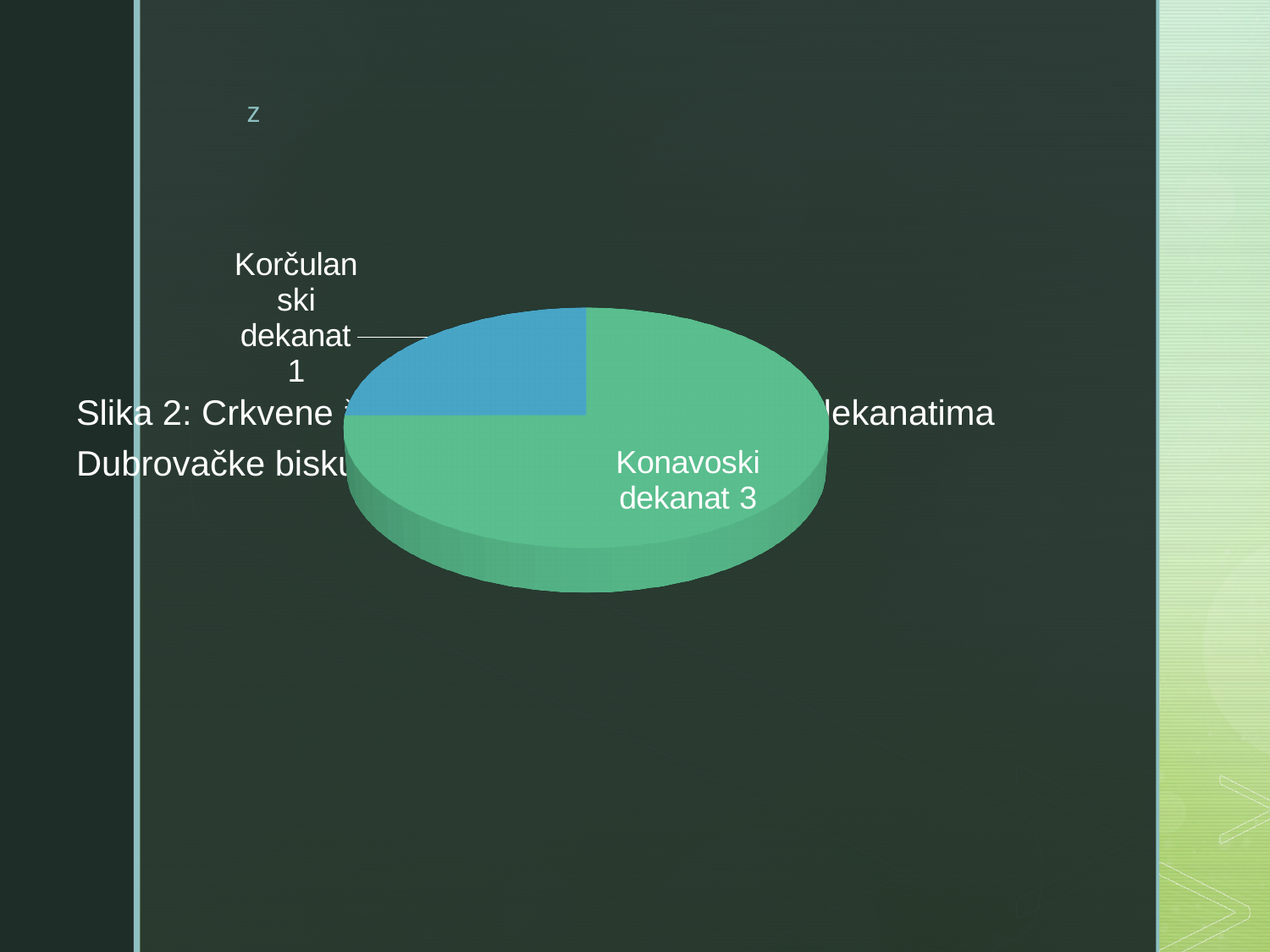
What is the difference between the values for Konavoski dekanat and Korčulanski dekanat? 2 How many categories (slices) does the pie chart have? 2 Which category has the smallest slice of the pie? Korčulanski dekanat What colour is the slice for Korčulanski dekanat? Blue What value is shown for Korčulanski dekanat? 1 What share of the pie does Korčulanski dekanat represent? 25% What is the total of all the slices in the pie chart? 4 What kind of chart is shown on the slide? Pie chart What value is shown for Konavoski dekanat? 3 Which category has the largest slice of the pie? Konavoski dekanat What share of the pie does Konavoski dekanat represent? 75% Which is larger, the value for Konavoski dekanat or the value for Korčulanski dekanat? Konavoski dekanat